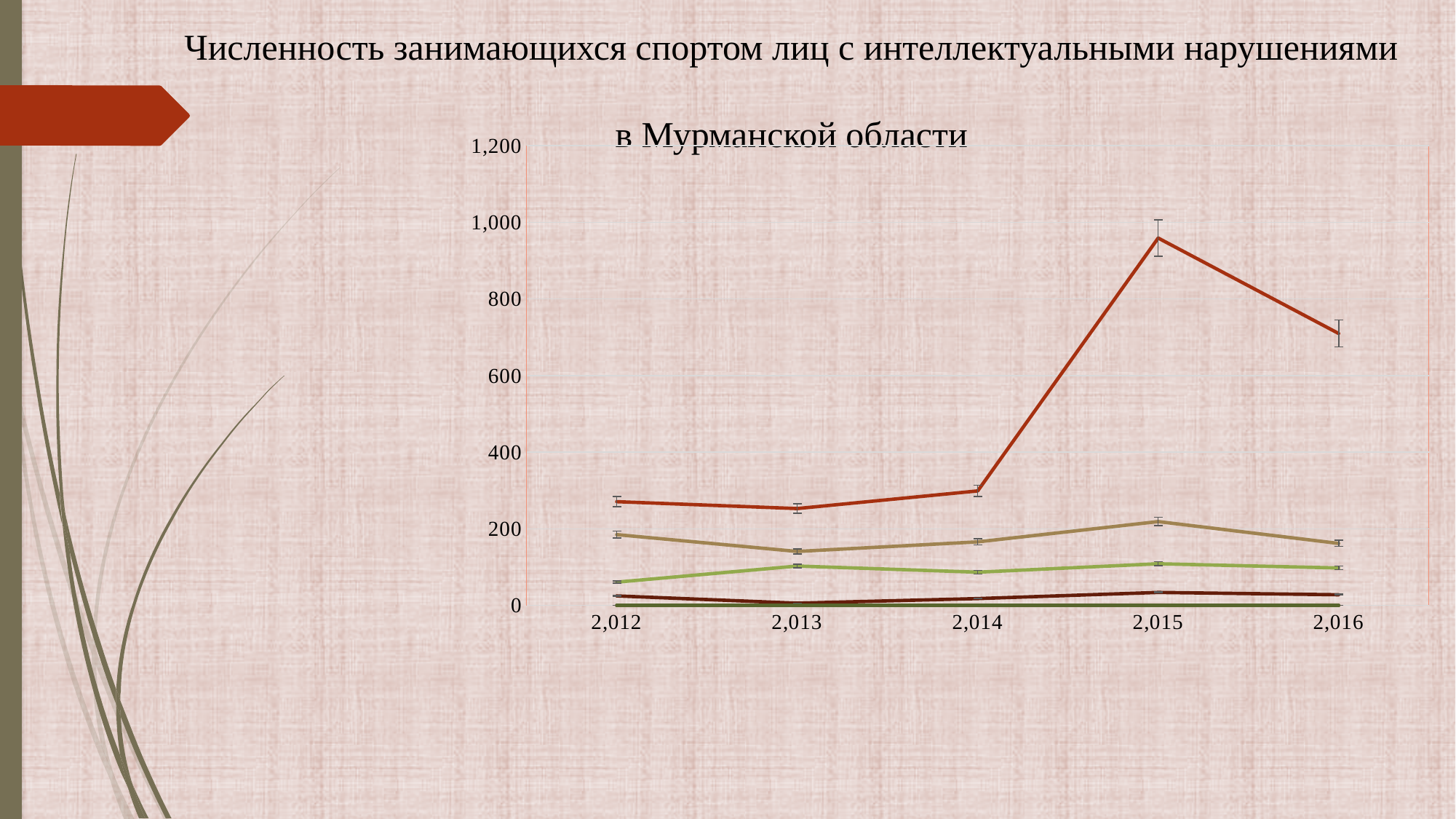
In 2,015, which line has the larger value, the red line or the tan line? the red line What kind of chart is shown on the slide? line chart What is the highest value shown on the y axis? 1,200 How many years are shown along the x axis of the chart? 5 Is the value of the tan line in 2,015 greater or less than 400? less What is the first year shown on the x axis? 2,012 Does the red line rise or fall between 2,014 and 2,015? rise Is the value of the red line in 2,015 greater or less than 800? greater In which year does the red line reach its highest value? 2,015 Is the value of the red line in 2,012 greater or less than 400? less Does the red line rise or fall between 2,015 and 2,016? fall